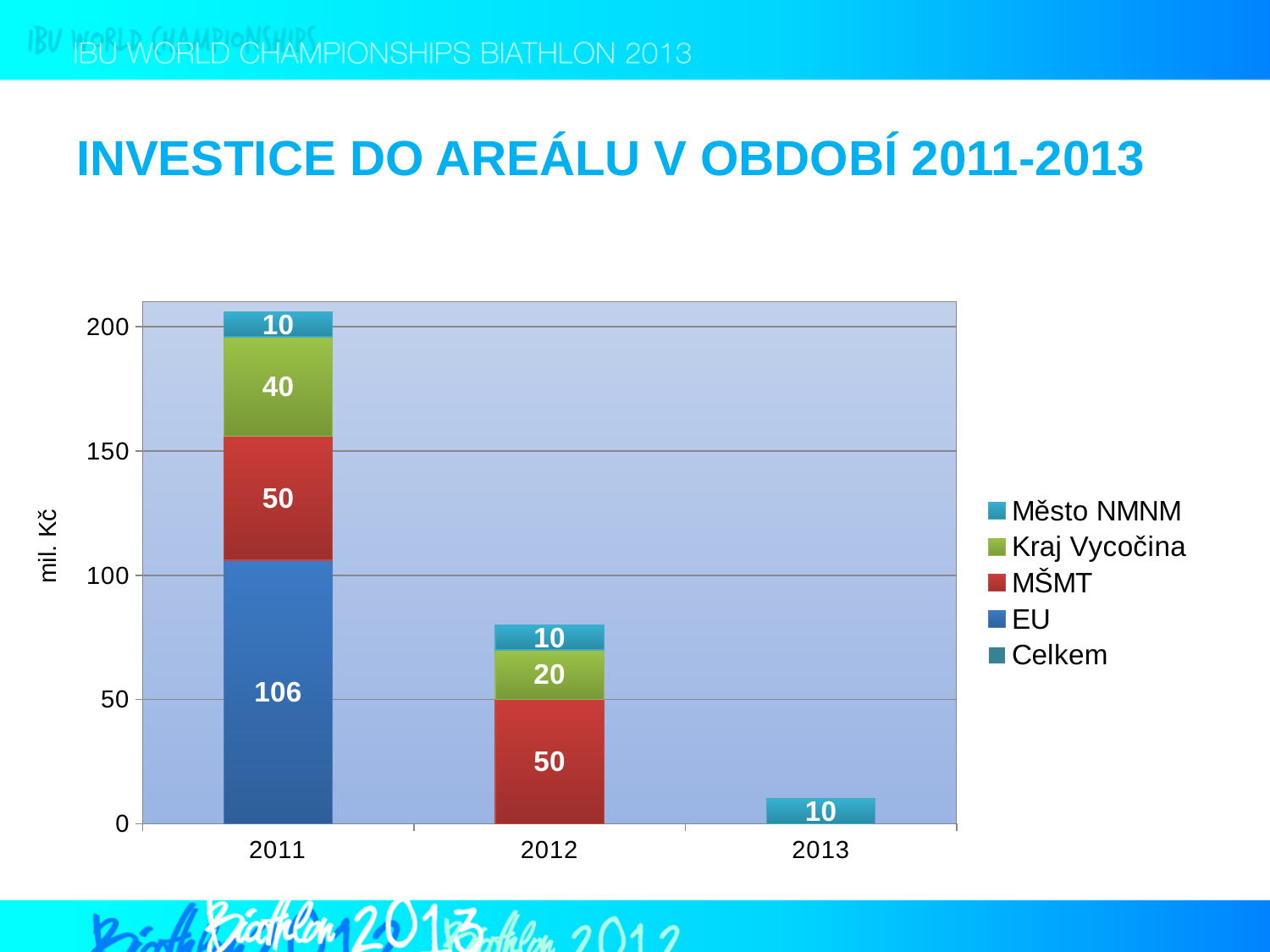
What is the value of the Kraj Vycočina segment for 2012? 20 What is the difference between the Kraj Vycočina values for 2011 and 2012? 20 Is the total for 2012 greater or less than 100? less What is the value of the EU segment for 2011? 106 Which year has the lowest total investment? 2013 What is the total of the stacked bar for 2012? 80 What kind of chart is shown on the slide? Stacked bar chart What is the total of the stacked bar for 2011? 206 How many series does the legend list? 5 What is the value of the MŠMT segment for 2012? 50 What is the value of the Město NMNM segment for 2013? 10 Which year has the highest total investment? 2011